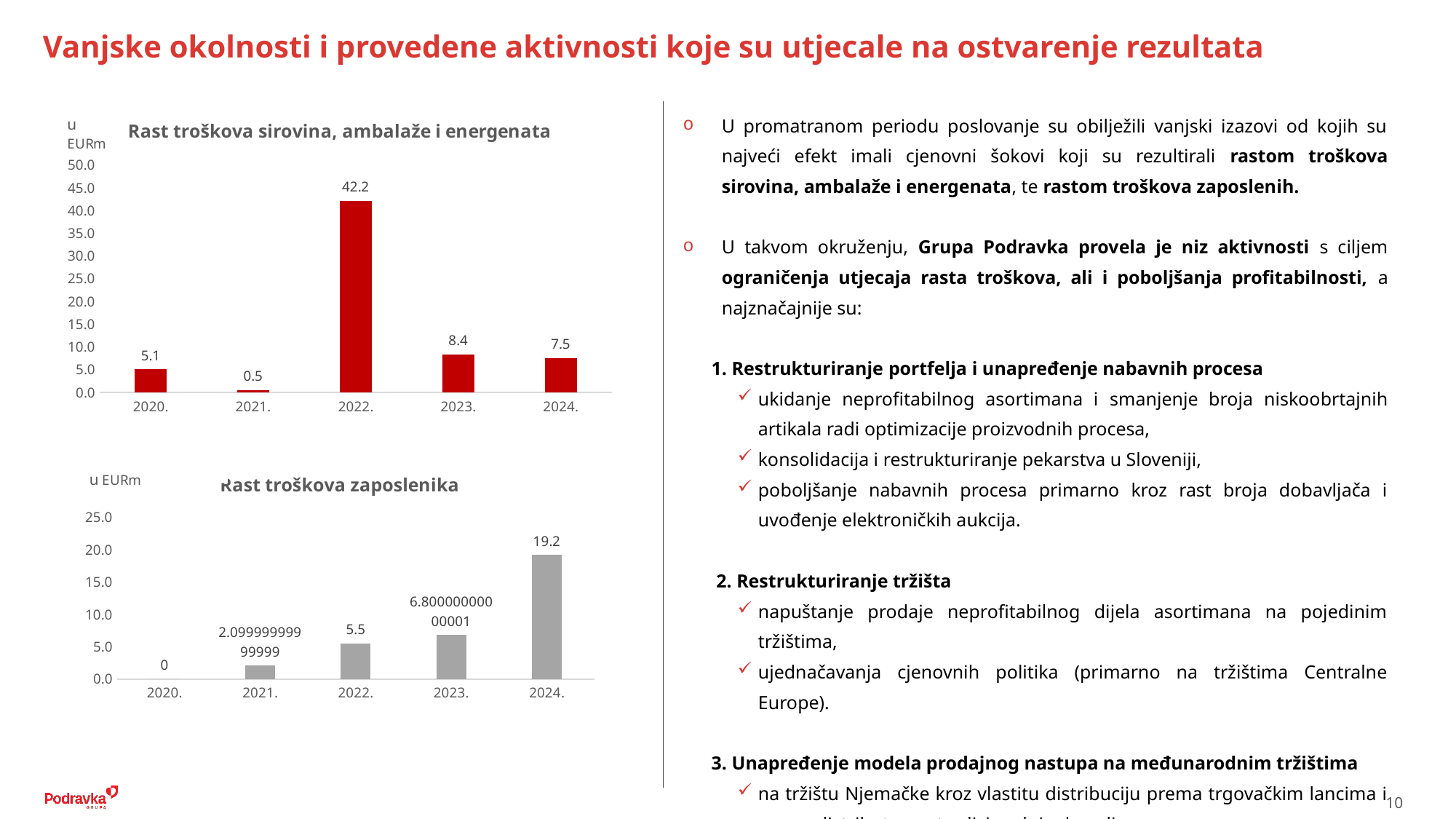
In the chart 'Rast troškova sirovina, ambalaže i energenata', which year has the highest value? 2022. In the chart 'Rast troškova sirovina, ambalaže i energenata', what is the value for 2022.? 42.2 In the chart 'Rast troškova zaposlenika', is the value for 2023. greater or less than 5.0? greater How many years are shown on the x axis of the chart 'Rast troškova zaposlenika'? 5 In the chart 'Rast troškova sirovina, ambalaže i energenata', which year has the lowest value? 2021. In the chart 'Rast troškova zaposlenika', what is the value for 2024.? 19.2 In the chart 'Rast troškova zaposlenika', what is the value for 2022.? 5.5 In the chart 'Rast troškova sirovina, ambalaže i energenata', what is the value for 2021.? 0.5 What type of chart is 'Rast troškova sirovina, ambalaže i energenata'? Bar chart In the chart 'Rast troškova sirovina, ambalaže i energenata', what is the difference between the values for 2023. and 2024.? 0.9 In the chart 'Rast troškova sirovina, ambalaže i energenata', which is larger, the value for 2020. or the value for 2024.? 2024. In the chart 'Rast troškova zaposlenika', which year has the highest value? 2024.